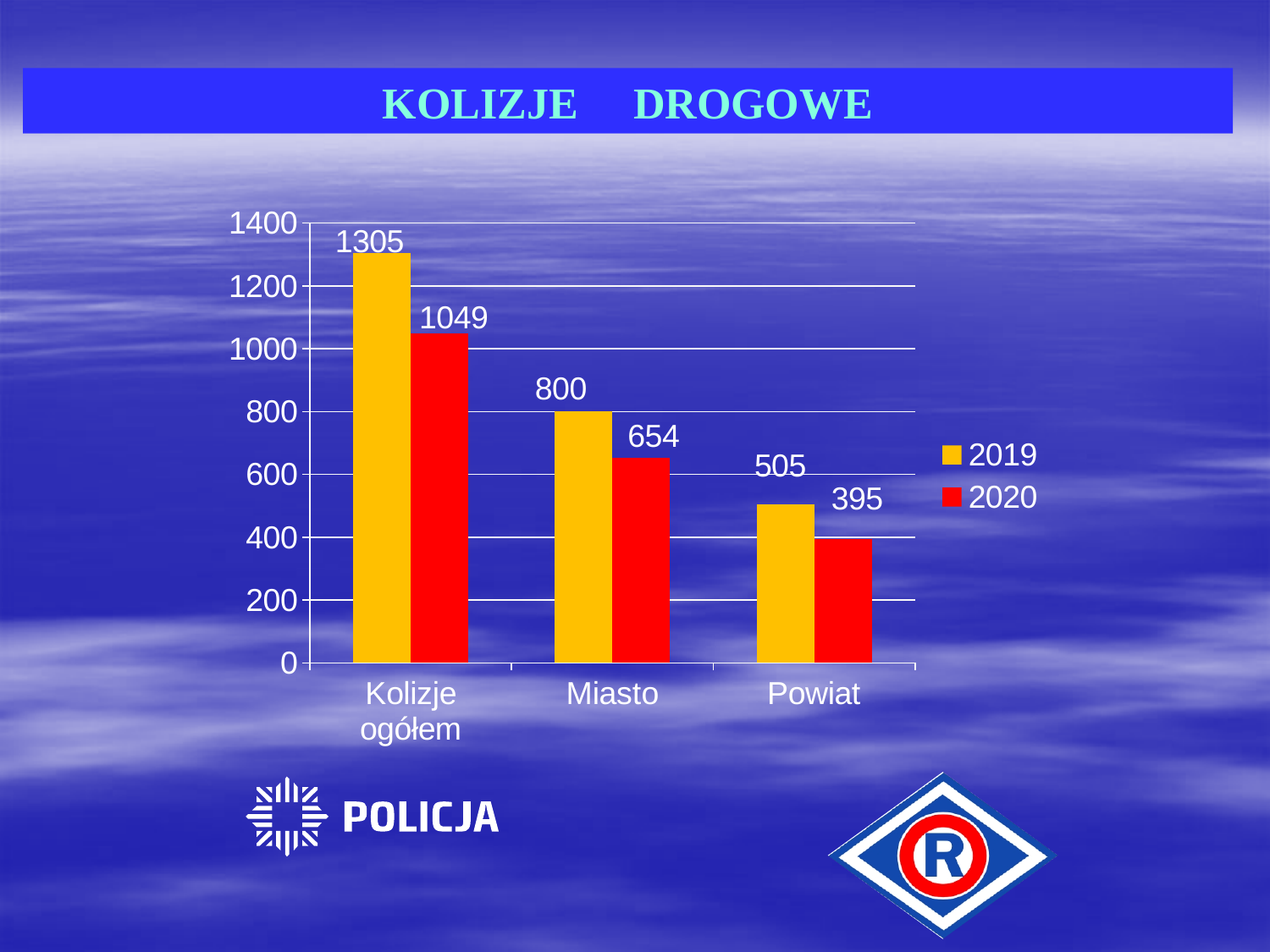
What is the value for Powiat in 2019? 505 Which category has the lowest value in 2020? Powiat What kind of chart is shown on the slide? bar chart What is the difference between the 2019 and 2020 values for Powiat? 110 How many categories are shown on the x axis? 3 What is the value for Miasto in 2020? 654 How many series does the legend list? 2 What is the title of the slide? KOLIZJE DROGOWE What is the value for Kolizje ogółem in 2019? 1305 What is the difference between the 2019 and 2020 values for Kolizje ogółem? 256 Which is larger, the 2019 value for Miasto or the 2020 value for Miasto? 2019 Which category has the highest value in 2019? Kolizje ogółem